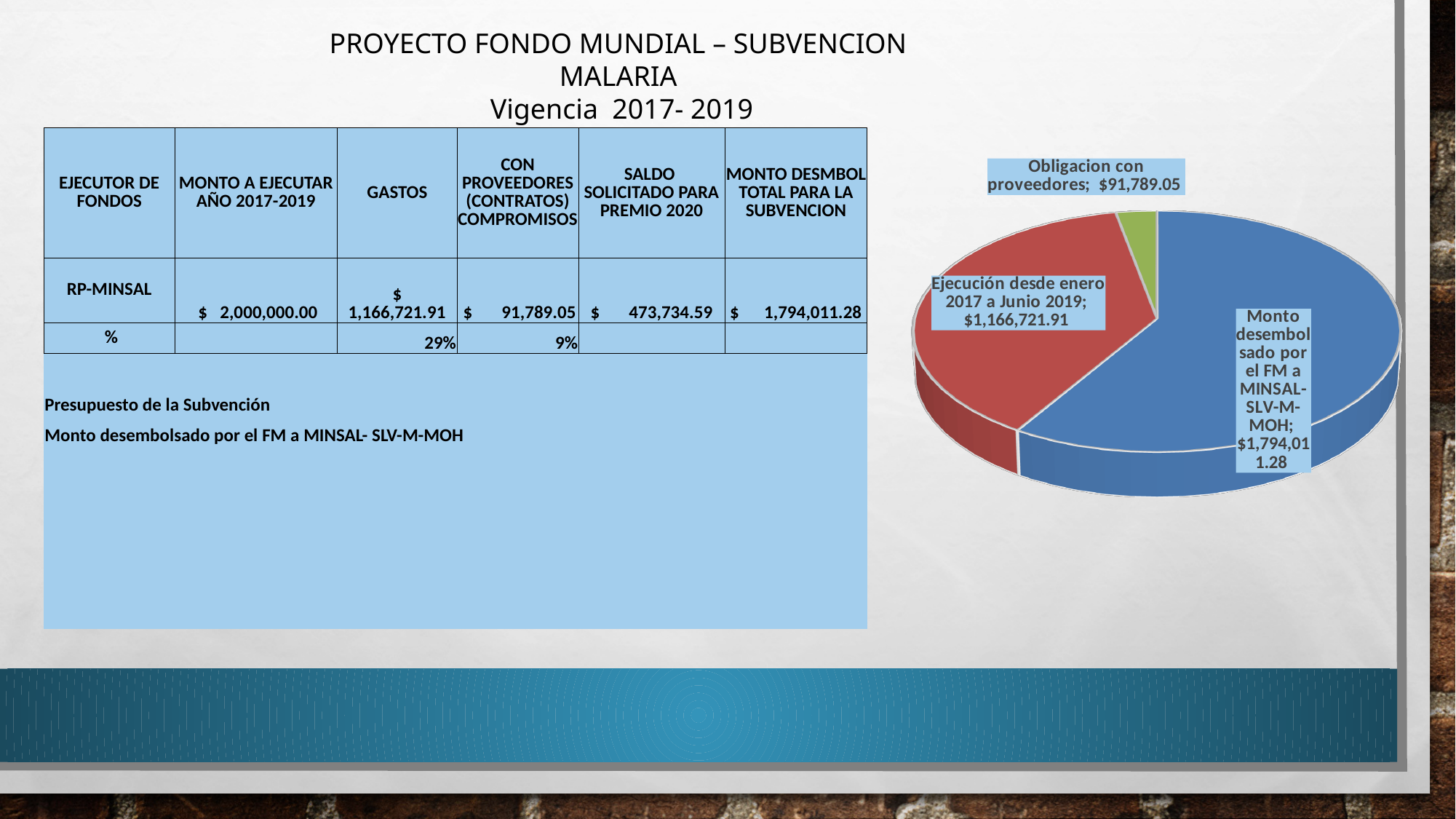
Which slice of the pie chart is the smallest? Obligacion con proveedores How many slices does the pie chart have? 3 What is the difference between the 'Ejecución desde enero 2017 a Junio 2019' slice and the 'Obligacion con proveedores' slice in the pie chart? $1,074,932.86 What is the value of the 'Obligacion con proveedores' slice in the pie chart? $91,789.05 What is the value of the 'Monto desembolsado por el FM a MINSAL-SLV-M-MOH' slice in the pie chart? $1,794,011.28 What colour is the 'Obligacion con proveedores' slice in the pie chart? Green What is the value of the 'Ejecución desde enero 2017 a Junio 2019' slice in the pie chart? $1,166,721.91 What is the difference between the 'Monto desembolsado por el FM a MINSAL-SLV-M-MOH' slice and the 'Ejecución desde enero 2017 a Junio 2019' slice in the pie chart? $627,289.37 Which slice of the pie chart is the largest? Monto desembolsado por el FM a MINSAL-SLV-M-MOH What type of chart is shown on the right side of the slide? Pie chart In the pie chart, which is larger: 'Ejecución desde enero 2017 a Junio 2019' or 'Obligacion con proveedores'? Ejecución desde enero 2017 a Junio 2019 What colour is the 'Monto desembolsado por el FM a MINSAL-SLV-M-MOH' slice in the pie chart? Blue